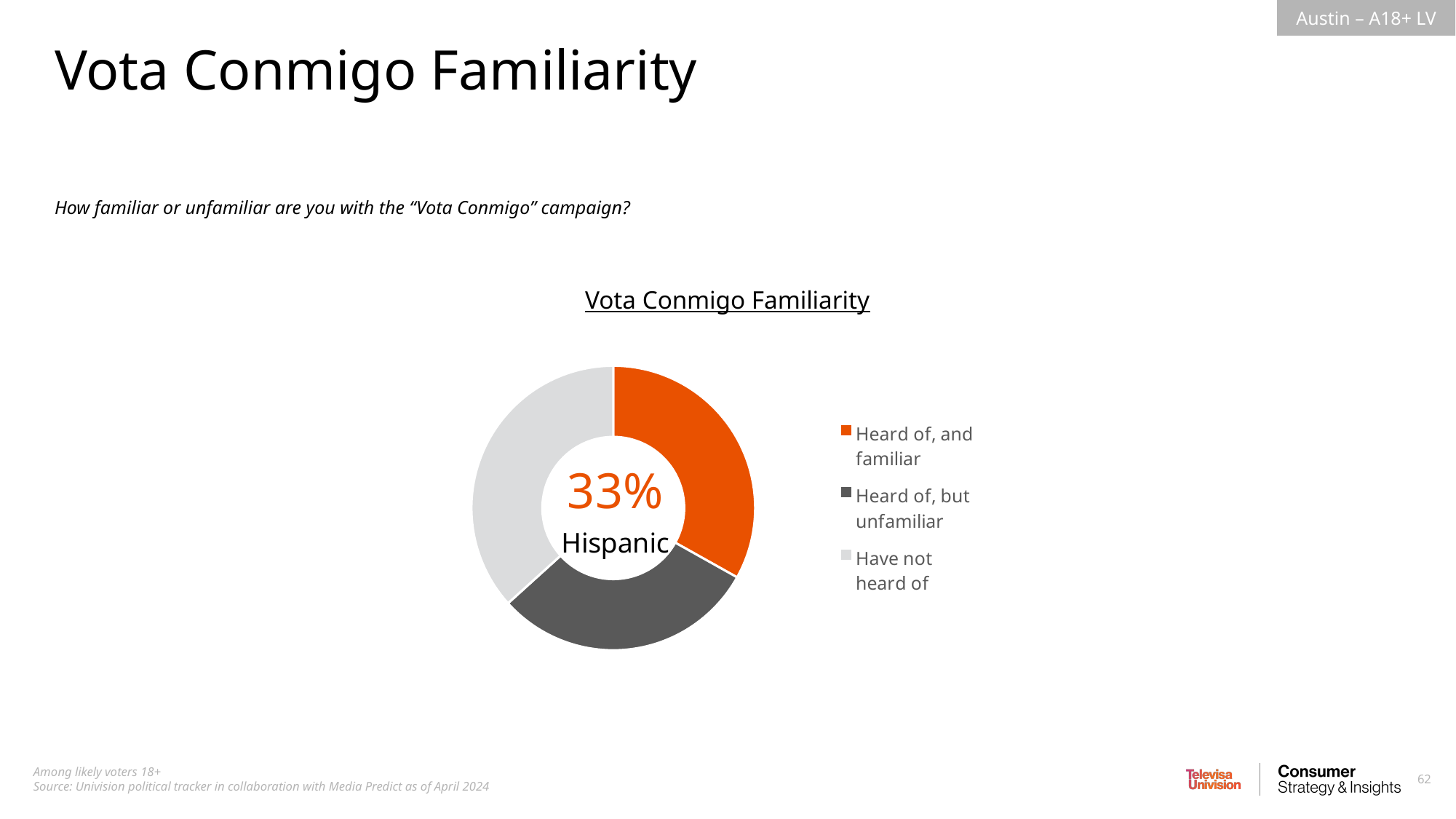
How many entries does the chart's legend list? 3 What percentage is printed in the centre of the donut chart? 33% Which legend entry is shown in orange? Heard of, and familiar What kind of chart is shown on the slide? donut chart What is the title of the chart? Vota Conmigo Familiarity How many slices does the donut chart have? 3